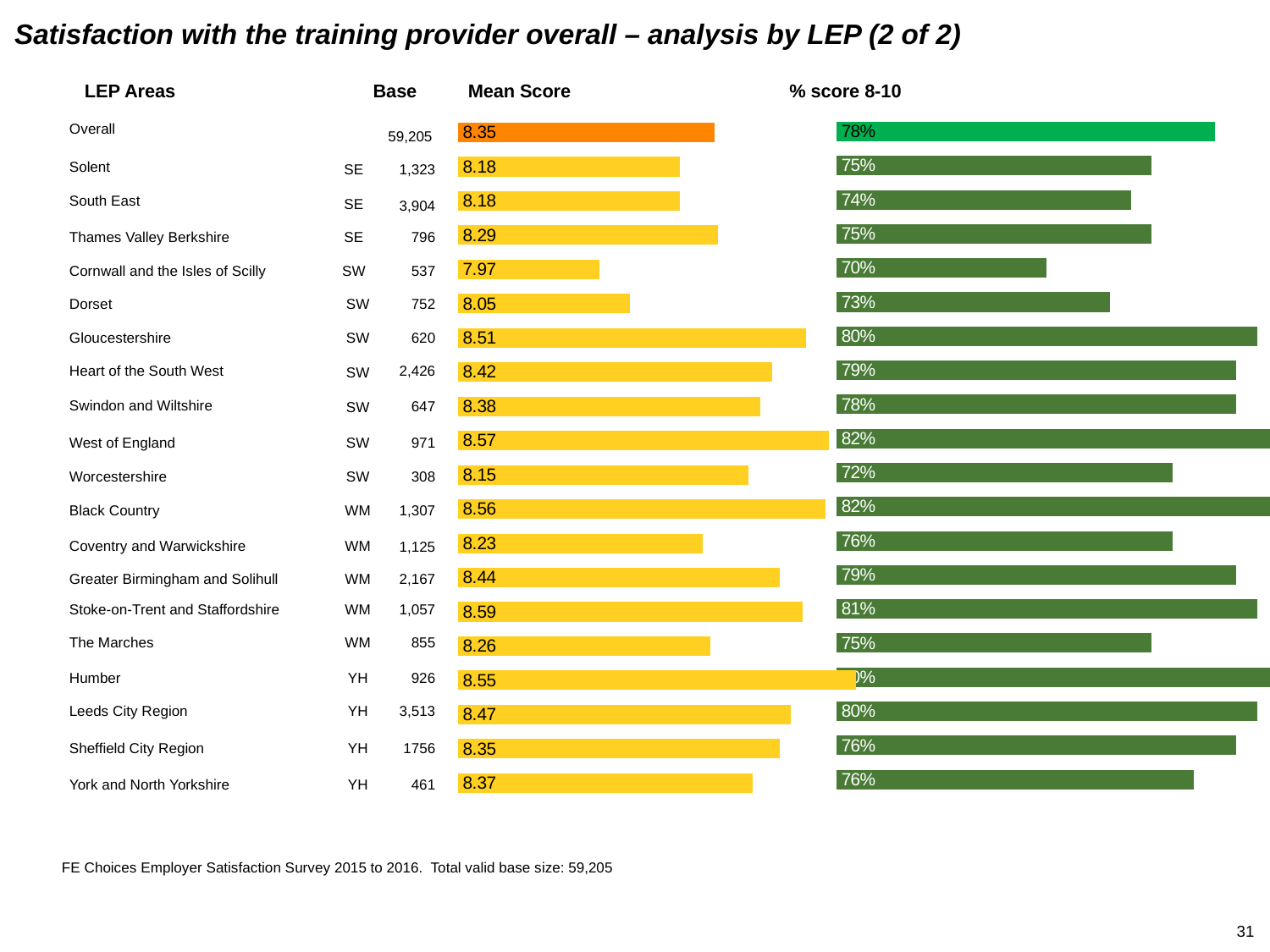
In the Mean Score chart, which LEP area has the lowest mean score? Cornwall and the Isles of Scilly In the % score 8-10 chart, what is the value for Cornwall and the Isles of Scilly? 70% In the Mean Score chart, what is the mean score for Gloucestershire? 8.51 What colour is the Overall bar in the Mean Score chart? Orange In the % score 8-10 chart, which LEP area has the lowest percentage? Cornwall and the Isles of Scilly In the Mean Score chart, what is the mean score for the Overall row? 8.35 In the % score 8-10 chart, which is higher: the value for Heart of the South West or for South East? Heart of the South West What kind of chart is used to show the Mean Score values? Bar chart In the Mean Score chart, which is higher: the mean score for Leeds City Region or for Coventry and Warwickshire? Leeds City Region In the % score 8-10 chart, what is the difference between the values for Black Country and Worcestershire? 10% In the Mean Score chart, what is the difference between the mean scores for West of England and Dorset? 0.52